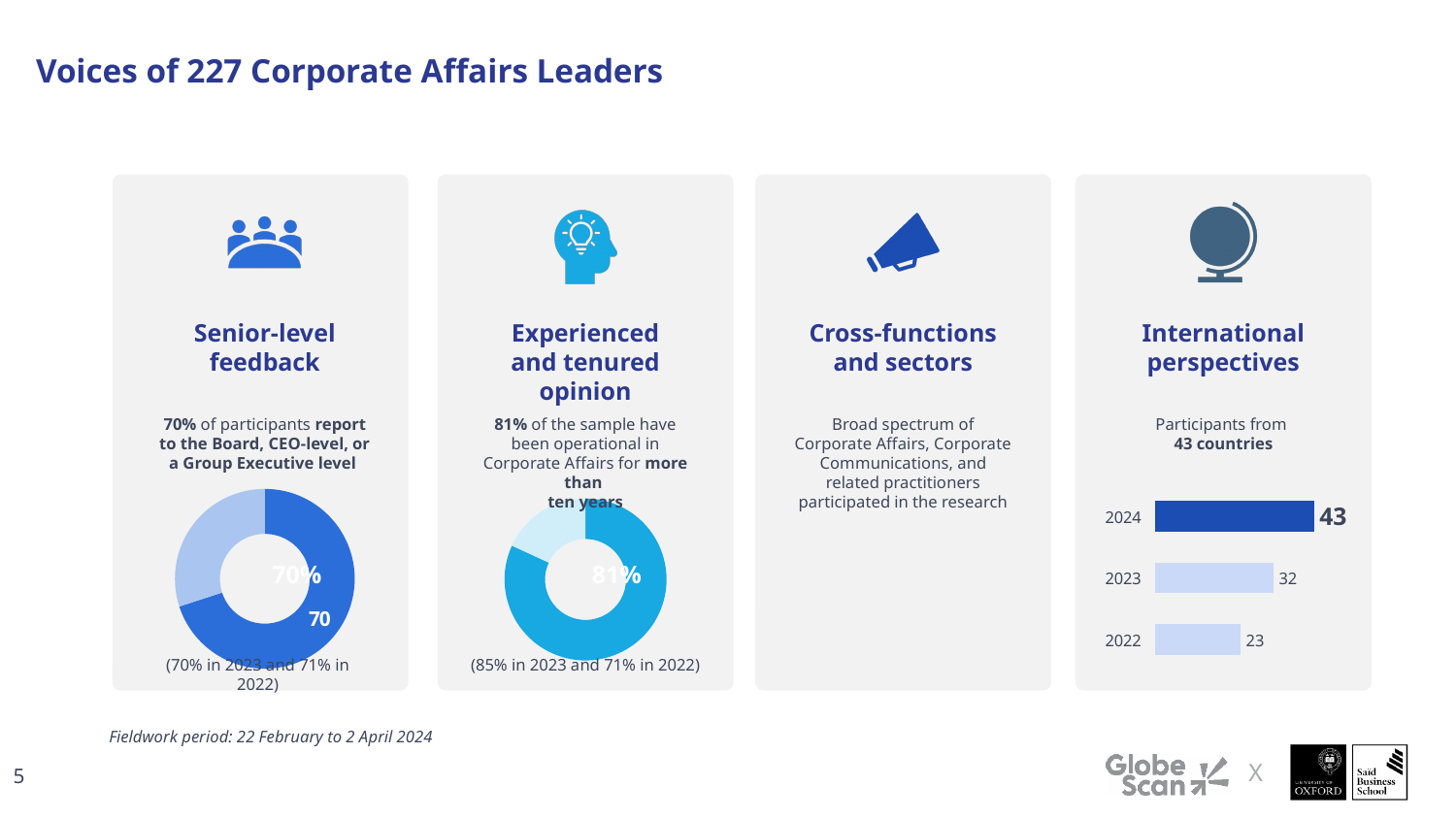
What kind of chart is used in the International perspectives panel? Bar chart In the International perspectives bar chart, what is the value for 2024? 43 In the International perspectives bar chart, do the values rise or fall from 2022 to 2024? Rise In the International perspectives bar chart, which is larger, the value for 2023 or the value for 2022? 2023 In the International perspectives bar chart, what is the difference between the 2024 and 2023 values? 11 What percentage is labelled on the donut chart in the Experienced and tenured opinion panel? 81% In the International perspectives bar chart, what is the value for 2022? 23 In the International perspectives bar chart, which year has the highest value? 2024 In the International perspectives bar chart, what is the difference between the 2023 and 2022 values? 9 What percentage is labelled on the donut chart in the Senior-level feedback panel? 70% In the International perspectives bar chart, which year has the lowest value? 2022 How many years are shown in the International perspectives bar chart? 3